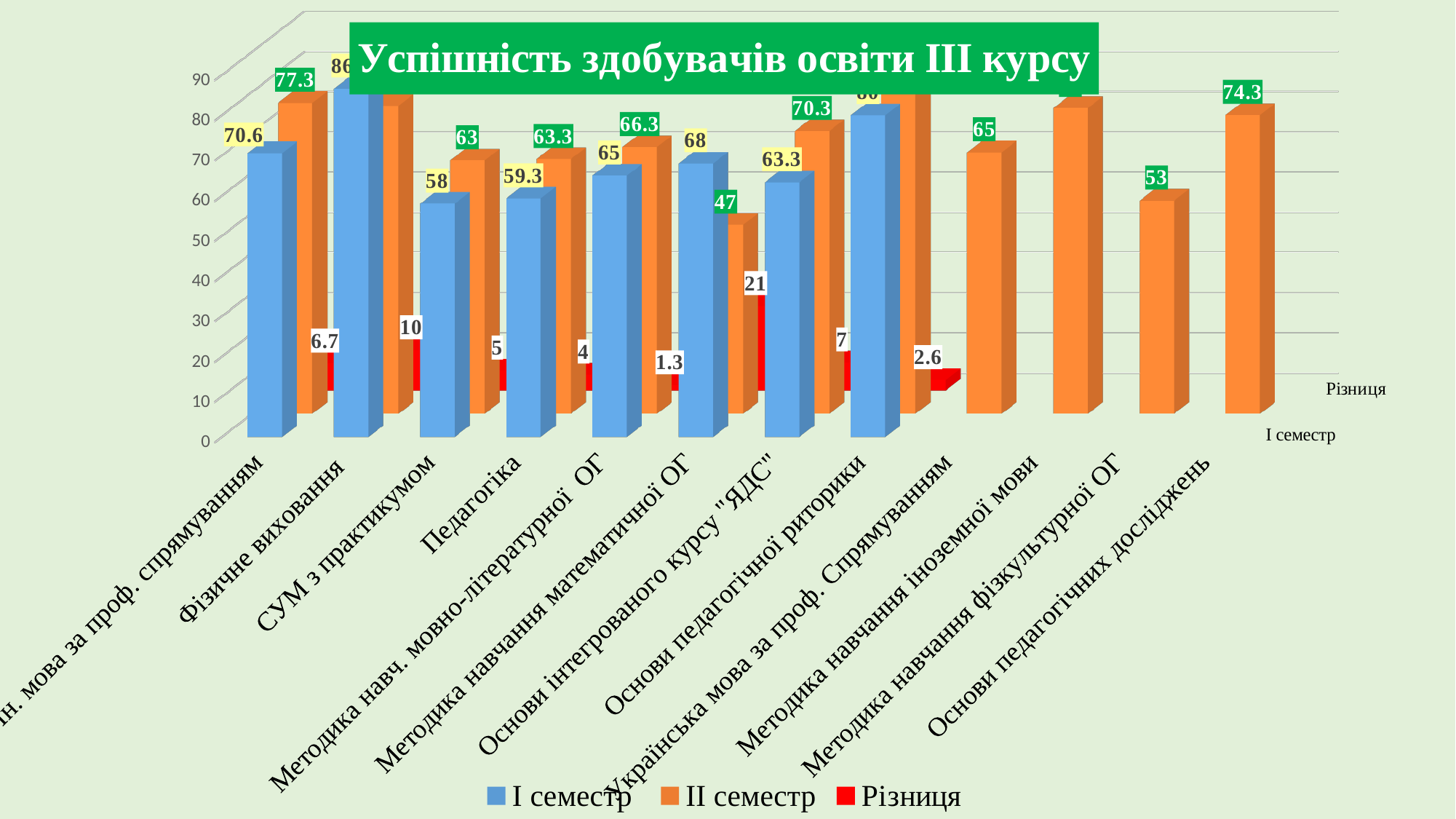
For Методика навчання математичної ОГ, which is larger: the І семестр value or the ІІ семестр value? І семестр Is the ІІ семестр value for Методика навчання іноземної мови greater or less than 70? greater How many series does the legend list? 3 What is the ІІ семестр value for Основи педагогічних досліджень? 74.3 Which category has the highest І семестр value? Фізичне виховання What is the Різниця value for Методика навчання математичної ОГ? 21 What is the difference between the ІІ семестр and І семестр values for Педагогіка? 4 What is the title of the chart? Успішність здобувачів освіти ІІІ курсу What is the ІІ семестр value for Педагогіка? 63.3 What is the І семестр value for СУМ з практикумом? 58 What kind of chart is shown on the slide? bar chart Which category has the highest Різниця value? Методика навчання математичної ОГ